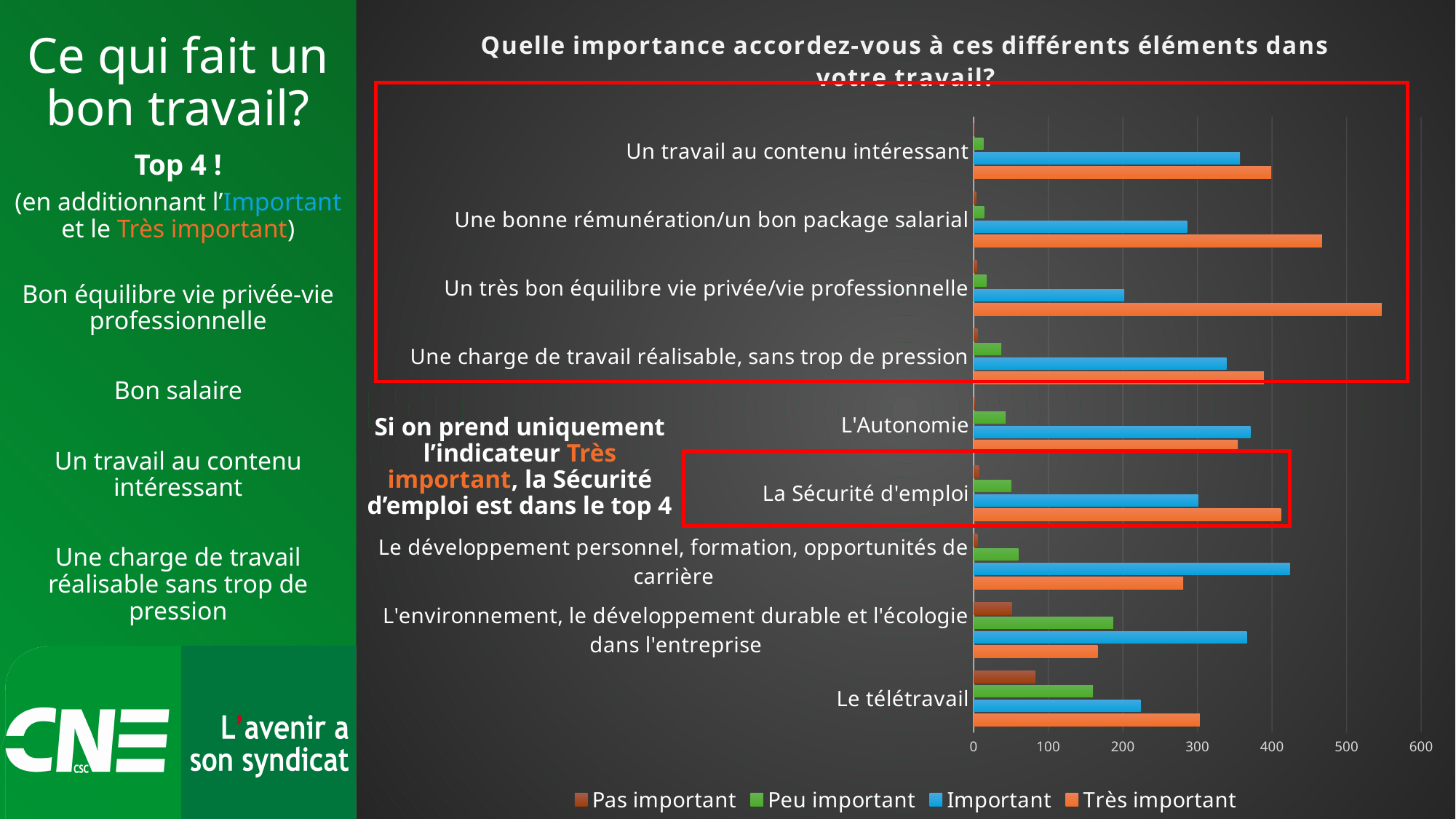
Which category has the highest 'Très important' value? Un très bon équilibre vie privée/vie professionnelle Is the 'Très important' value for 'Un très bon équilibre vie privée/vie professionnelle' greater or less than 500? greater Which category has the lowest 'Très important' value? L'environnement, le développement durable et l'écologie dans l'entreprise Which category has the highest 'Pas important' value? Le télétravail How many series does the chart legend list? 4 How many categories are plotted on the chart? 9 What colour represents the 'Très important' series in the chart? Orange Which is larger: the 'Pas important' value for 'Le télétravail' or for 'Un travail au contenu intéressant'? Le télétravail For 'Le développement personnel, formation, opportunités de carrière', which is larger: the 'Important' value or the 'Très important' value? Important Is the 'Très important' value for 'Le télétravail' greater or less than 200? greater Is the 'Important' value for 'Un très bon équilibre vie privée/vie professionnelle' greater or less than 300? less What kind of chart is shown on the slide? Bar chart